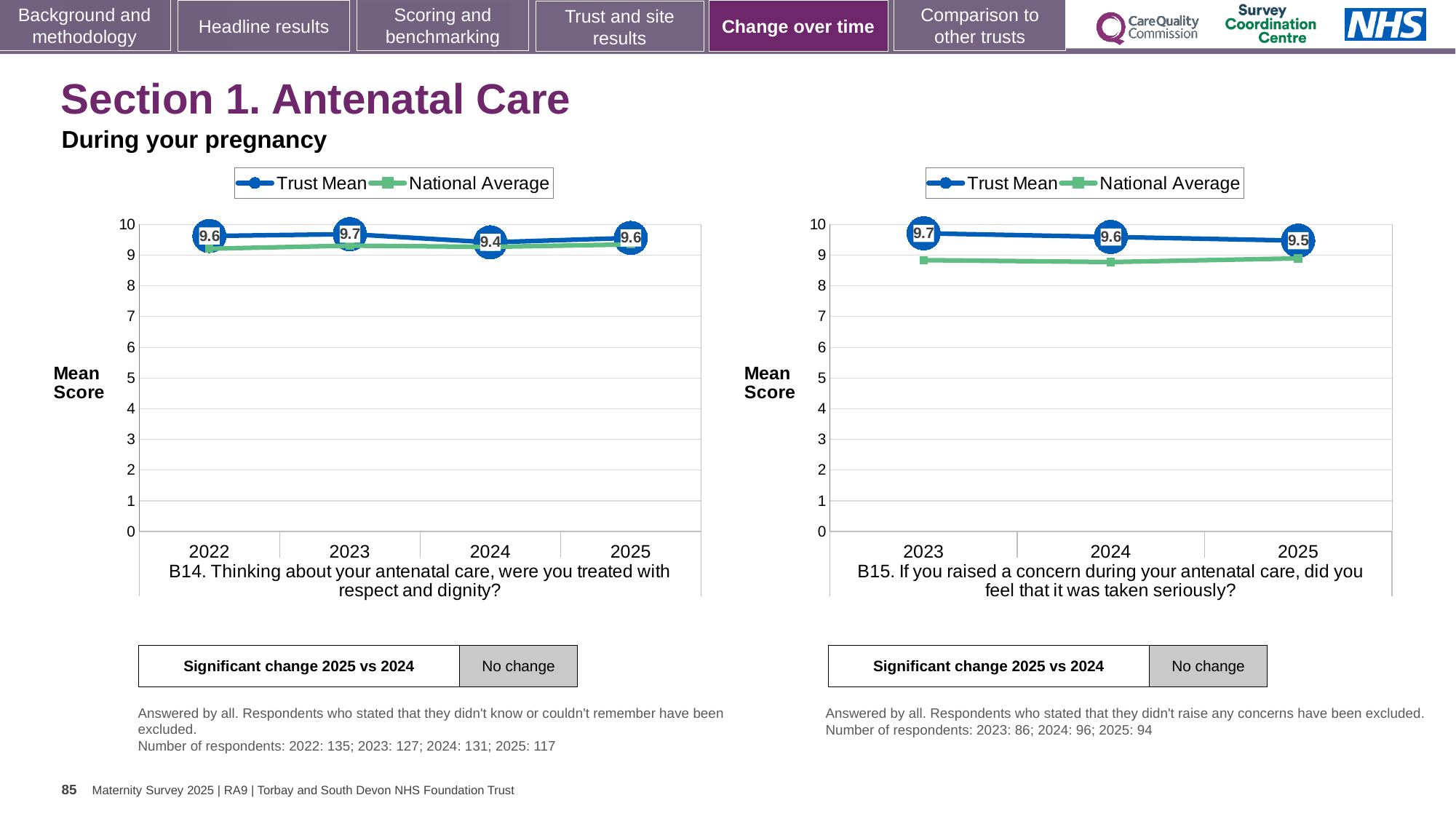
In the B14 chart on the left, what is the difference between the Trust Mean for 2023 and 2024? 0.3 In the B14 chart on the left, what is the Trust Mean for 2023? 9.7 How many years are plotted in the B14 chart on the left? 4 In the B14 chart on the left, which year has the lowest Trust Mean? 2024 In the B14 chart on the left, which year has the highest Trust Mean? 2023 In the B15 chart on the right, which year has the lowest Trust Mean? 2025 In the B15 chart on the right, is the National Average for 2023 greater or less than 9? less How many series does the legend of the B15 chart on the right list? 2 In the B15 chart on the right, what is the difference between the Trust Mean for 2023 and 2025? 0.2 In the B15 chart on the right, what is the Trust Mean for 2025? 9.5 In the B15 chart on the right, does the Trust Mean rise or fall from 2023 to 2025? fall In the B14 chart on the left, what is the Trust Mean for 2024? 9.4